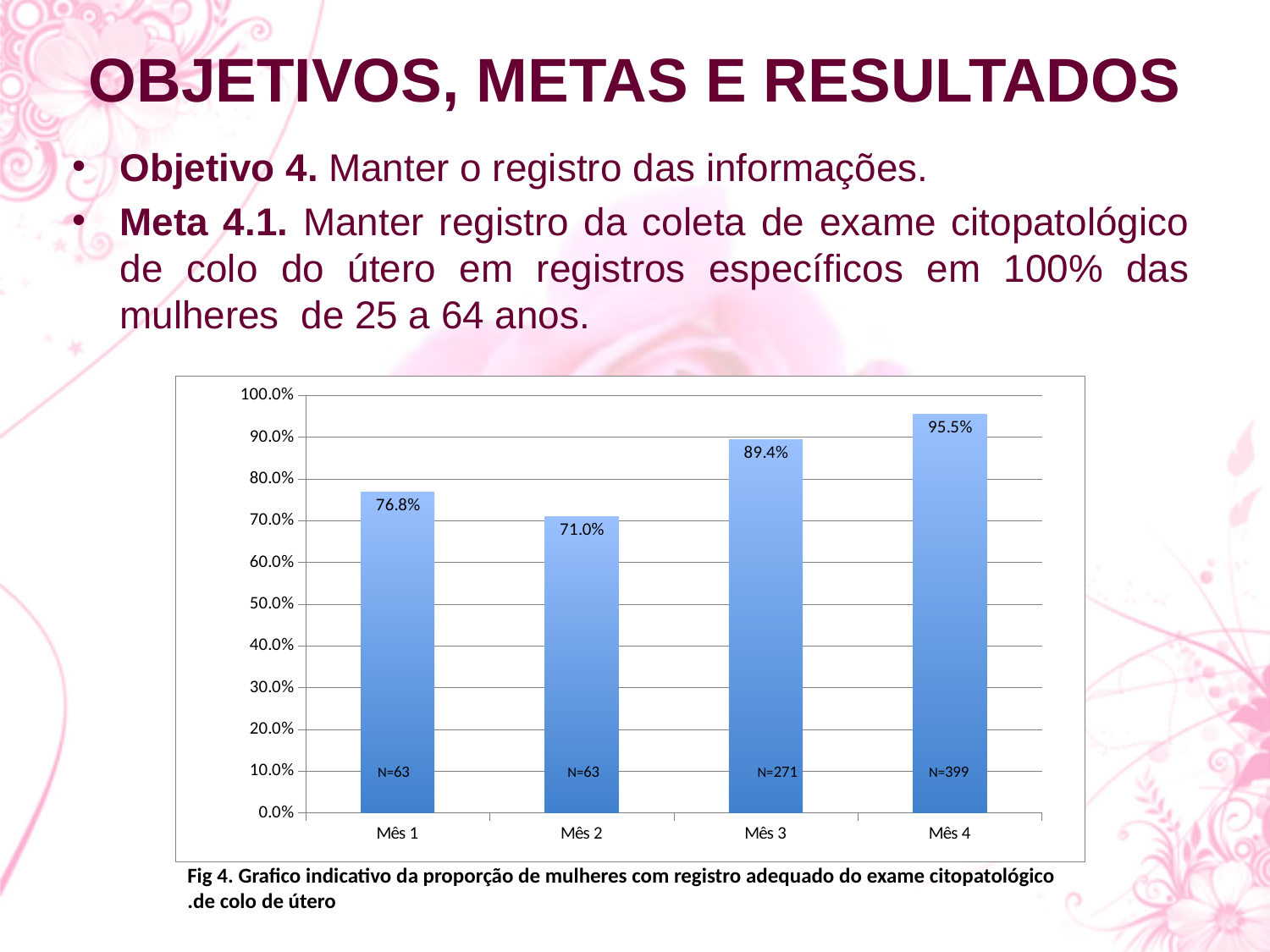
What is the value for Mês 2? 71.0% What is the value for Mês 3? 89.4% How many months are shown on the x axis? 4 Which month has the highest value? Mês 4 What kind of chart is shown on the slide? bar chart What is the value for Mês 4? 95.5% Which month has the lowest value? Mês 2 What is the difference between the values for Mês 4 and Mês 1? 18.7% Which is larger, the value for Mês 2 or the value for Mês 3? Mês 3 Is the value for Mês 3 greater or less than 80.0%? greater What N value is printed on the bar for Mês 3? N=271 What is the value for Mês 1? 76.8%